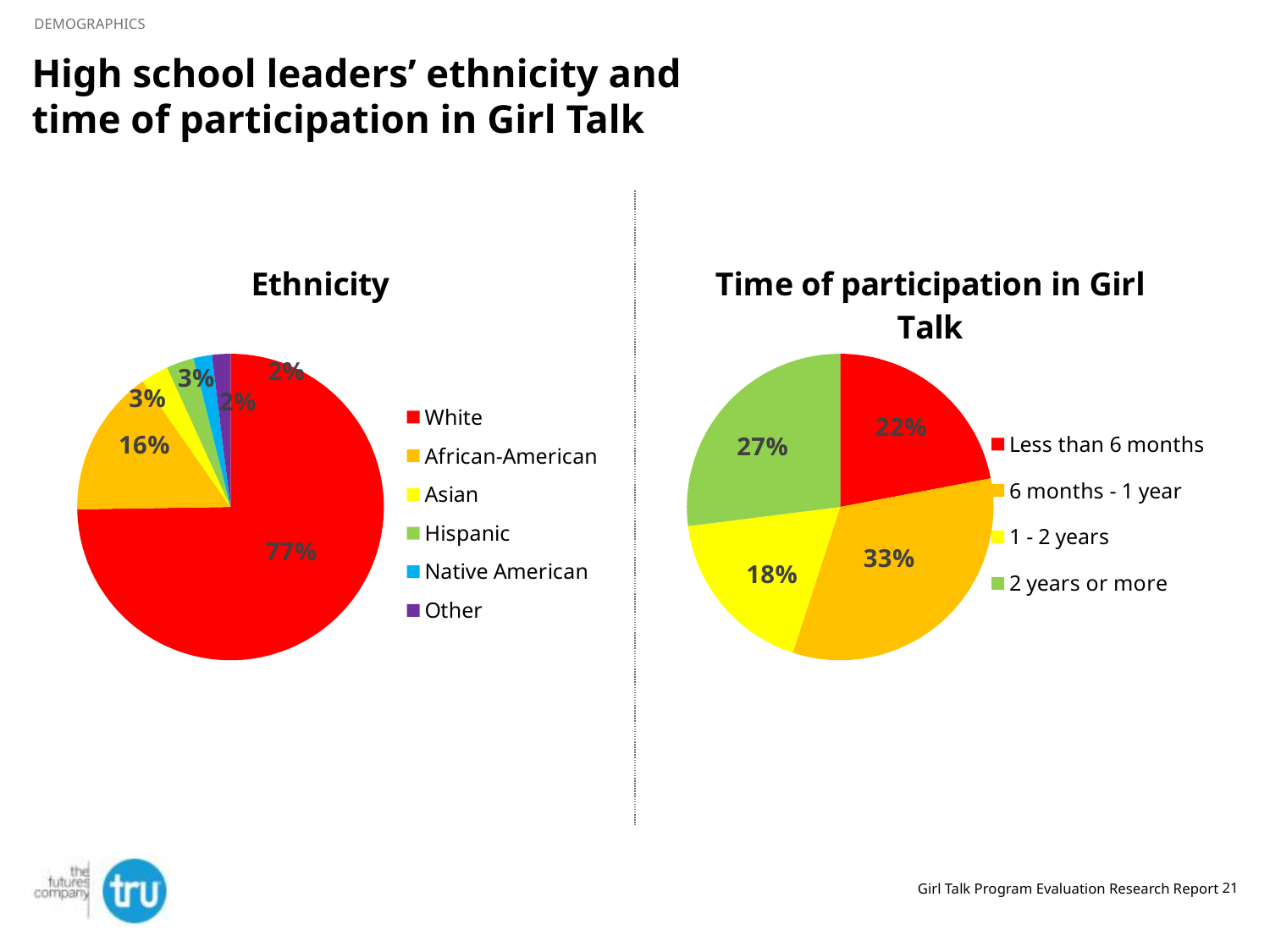
In the Time of participation in Girl Talk chart, what percentage participated for 2 years or more? 27% In the Time of participation in Girl Talk chart, what is the difference between the 6 months - 1 year share and the 1 - 2 years share? 15 percentage points In the Ethnicity chart, what is the difference between the White and African-American shares? 61 percentage points What type of chart is the Ethnicity chart? Pie chart In the Ethnicity chart, what percentage of high school leaders are White? 77% In the Time of participation in Girl Talk chart, which is larger: Less than 6 months or 2 years or more? 2 years or more In the Ethnicity chart, which ethnicity has the largest slice? White In the Time of participation in Girl Talk chart, what colour is the slice for Less than 6 months? Red In the Time of participation in Girl Talk chart, which category has the smallest share? 1 - 2 years In the Ethnicity chart, what share is African-American? 16% How many categories does the legend of the Ethnicity chart list? 6 In the Time of participation in Girl Talk chart, what percentage participated for 6 months - 1 year? 33%